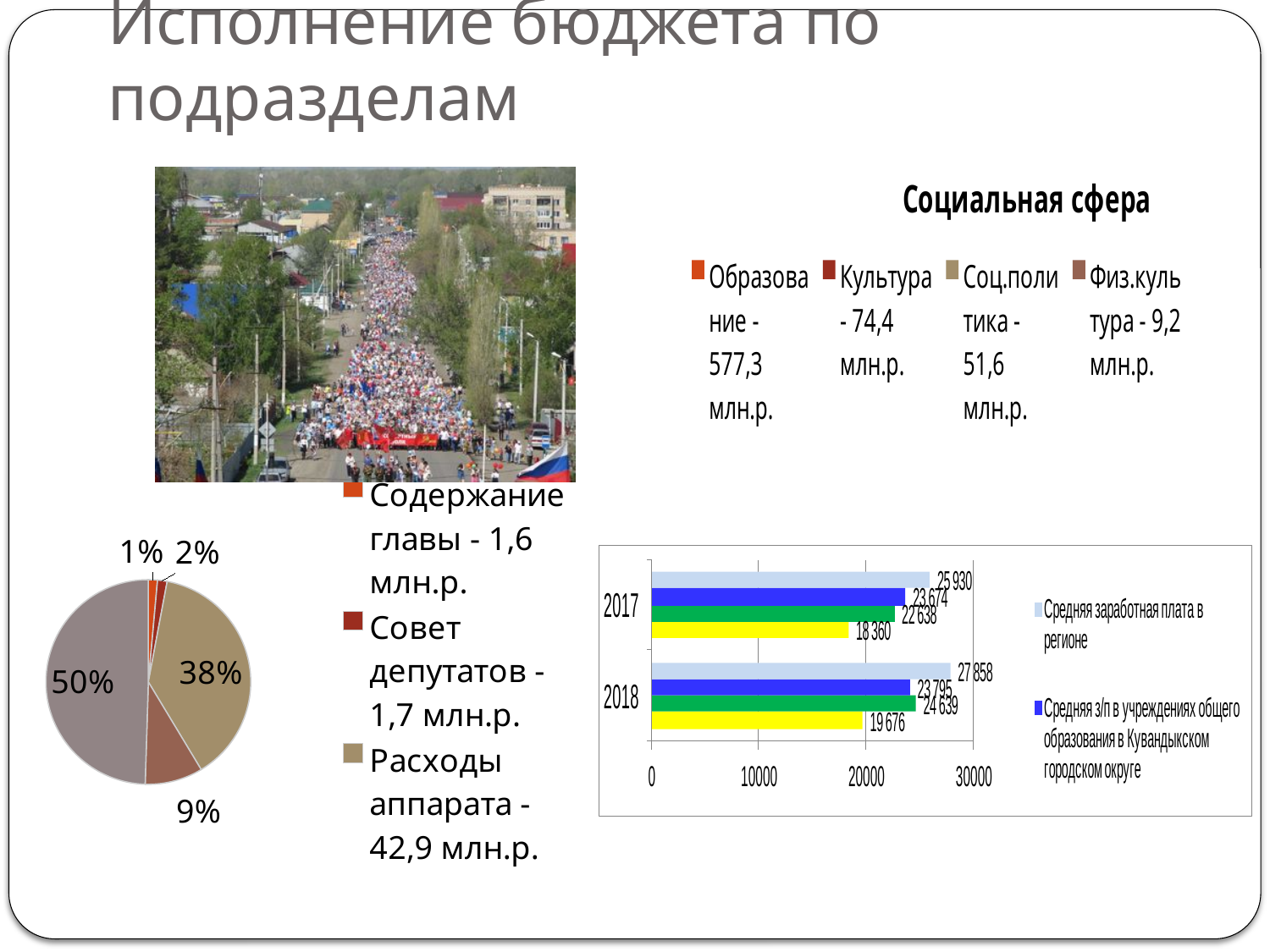
In the bar chart at the bottom right, does 'Средняя заработная плата в регионе' rise or fall from 2017 to 2018? rises In the bar chart at the bottom right, what is the value of 'Средняя з/п в учреждениях общего образования в Кувандыкском городском округе' for 2018? 23 795 In the bar chart at the bottom right, what is the value of 'Средняя заработная плата в регионе' for 2017? 25 930 In the bar chart at the bottom right, what is the value of 'Средняя з/п в учреждениях общего образования в Кувандыкском городском округе' for 2017? 23 674 How many entries does the legend of the 'Социальная сфера' chart list? 4 In the bar chart at the bottom right, by how much did 'Средняя заработная плата в регионе' increase from 2017 to 2018? 1 928 In the bar chart at the bottom right, what is the value of 'Средняя заработная плата в регионе' for 2018? 27 858 In the bar chart at the bottom right, what is the smallest value shown for 2018? 19 676 In the bar chart at the bottom right, which is larger for 2017: 'Средняя заработная плата в регионе' or 'Средняя з/п в учреждениях общего образования в Кувандыкском городском округе'? Средняя заработная плата в регионе In the pie chart at the bottom left, what share does 'Расходы аппарата - 42,9 млн.р.' have? 38% What kind of chart is shown at the bottom right of the slide? bar chart In the pie chart at the bottom left, what is the share of the largest slice? 50%